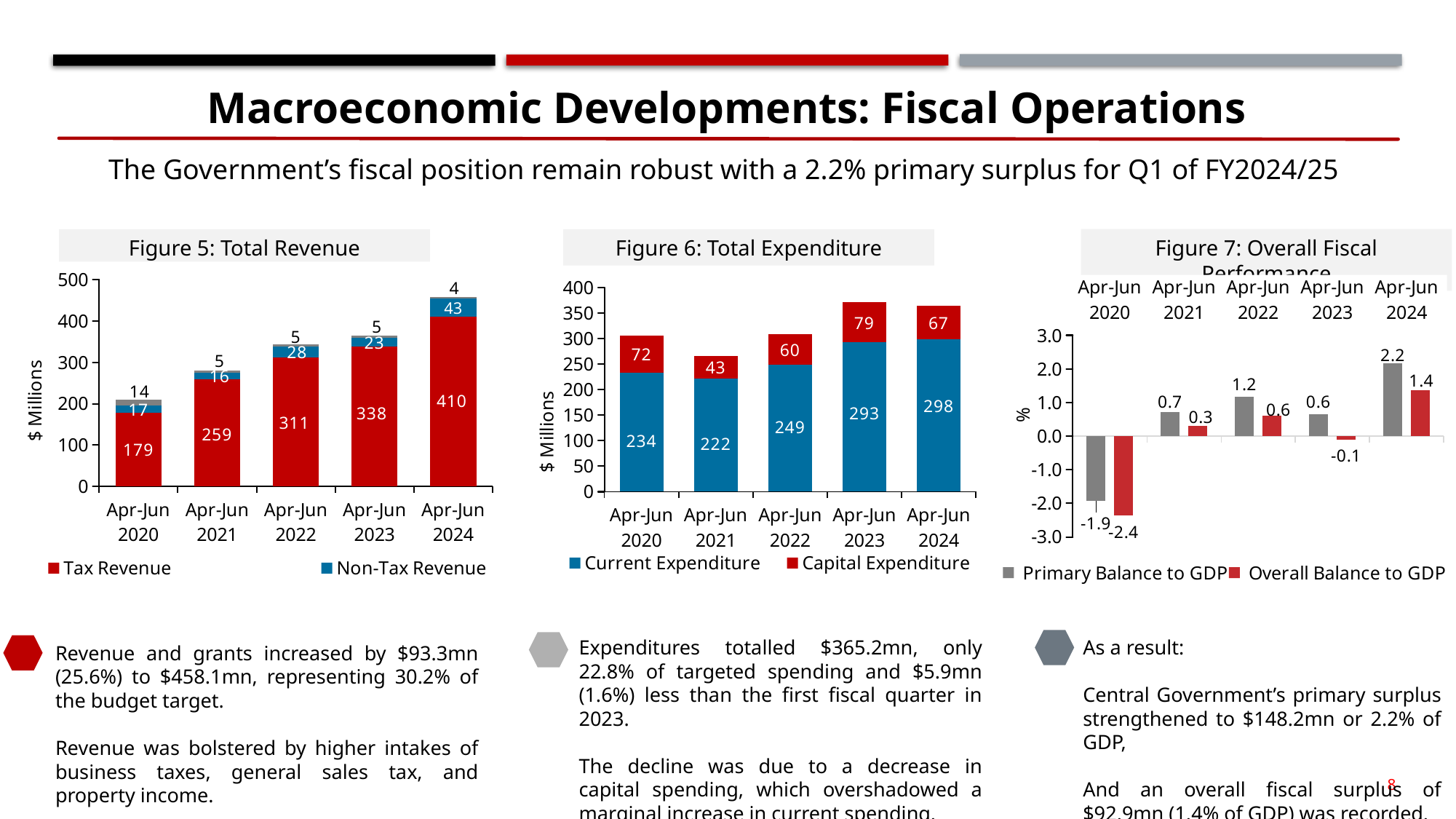
In Figure 5: Total Revenue, what is the Tax Revenue value for Apr-Jun 2024? 410 In Figure 7: Overall Fiscal Performance, which is larger for Apr-Jun 2022, Primary Balance to GDP or Overall Balance to GDP? Primary Balance to GDP How many series does the legend of Figure 6: Total Expenditure list? 2 In Figure 5: Total Revenue, what is the Non-Tax Revenue value for Apr-Jun 2022? 28 How many periods are shown on the x axis of Figure 7: Overall Fiscal Performance? 5 In Figure 6: Total Expenditure, which period has the lowest Current Expenditure? Apr-Jun 2021 In Figure 5: Total Revenue, which period has the highest Tax Revenue? Apr-Jun 2024 In Figure 6: Total Expenditure, what is the Capital Expenditure value for Apr-Jun 2023? 79 In Figure 7: Overall Fiscal Performance, which period has the lowest Overall Balance to GDP? Apr-Jun 2020 In Figure 7: Overall Fiscal Performance, what is the Overall Balance to GDP for Apr-Jun 2023? -0.1 In Figure 6: Total Expenditure, what is the total of the stacked bar for Apr-Jun 2024? 365 In Figure 5: Total Revenue, by how much did Tax Revenue increase from Apr-Jun 2023 to Apr-Jun 2024? 72